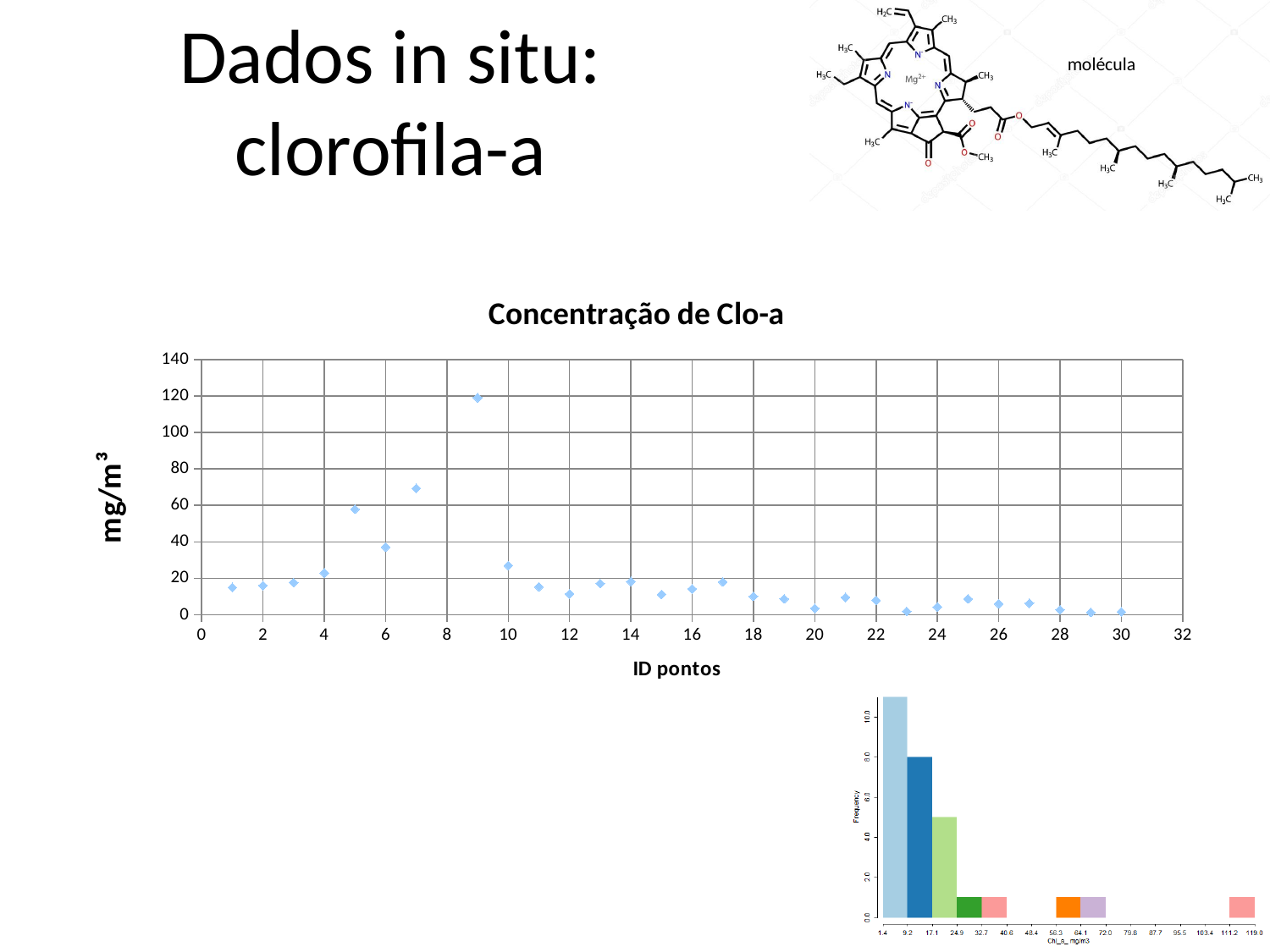
In the chart titled 'Concentração de Clo-a', do the values generally rise or fall from ID ponto 10 to ID ponto 30? fall In the chart titled 'Concentração de Clo-a', is the value for ID ponto 7 greater or less than 60? greater In the chart titled 'Concentração de Clo-a', is the value for ID ponto 10 greater or less than 20? greater In the chart titled 'Concentração de Clo-a', which has the larger value, ID ponto 4 or ID ponto 20? ID ponto 4 In the chart titled 'Concentração de Clo-a', is the value for ID ponto 1 greater or less than 20? less In the chart titled 'Concentração de Clo-a', which has the larger value, ID ponto 5 or ID ponto 6? ID ponto 5 In the chart titled 'Concentração de Clo-a', what is the label of the x axis? ID pontos In the chart titled 'Concentração de Clo-a', which ID ponto has the highest concentration? 9 In the chart titled 'Concentração de Clo-a', what is the label of the y axis? mg/m³ In the chart titled 'Concentração de Clo-a', how many data points are plotted? 29 In the chart titled 'Concentração de Clo-a', what kind of chart is used to show the data? scatter chart